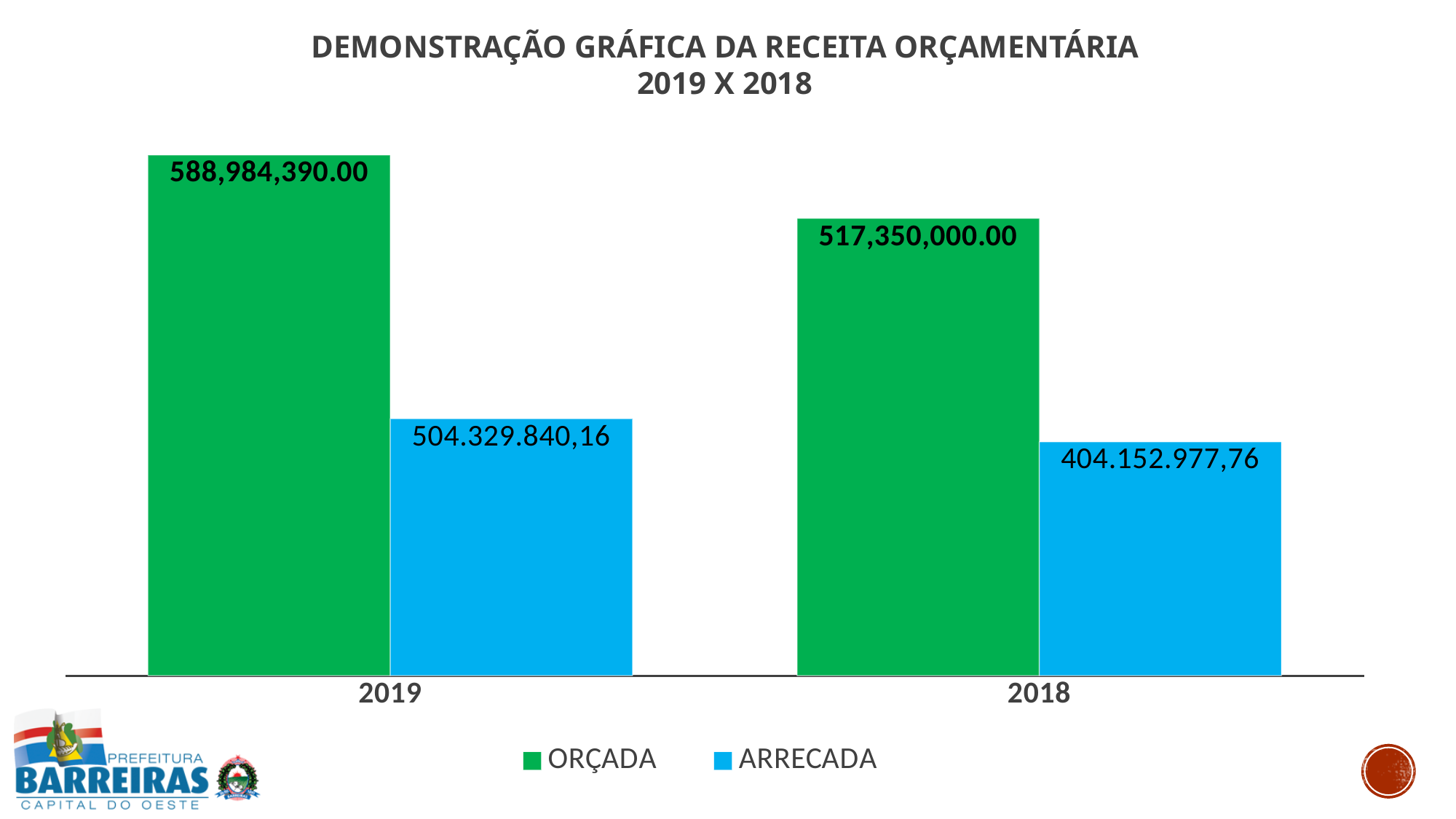
What is the ARRECADA value for 2018? 404.152.977,76 Which year has the higher ORÇADA value? 2019 What is the difference between the ARRECADA values for 2019 and 2018? 100.176.862,40 What kind of chart is shown on the slide? bar chart What is the difference between the ORÇADA values for 2019 and 2018? 71,634,390.00 How many years (categories) are shown on the x axis? 2 What is the ARRECADA value for 2019? 504.329.840,16 Is the ARRECADA value for 2018 larger or smaller than the ORÇADA value for 2018? smaller Which bar on the chart is the lowest? ARRECADA 2018 What is the ORÇADA value for 2019? 588,984,390.00 What is the ORÇADA value for 2018? 517,350,000.00 How many series does the legend list? 2